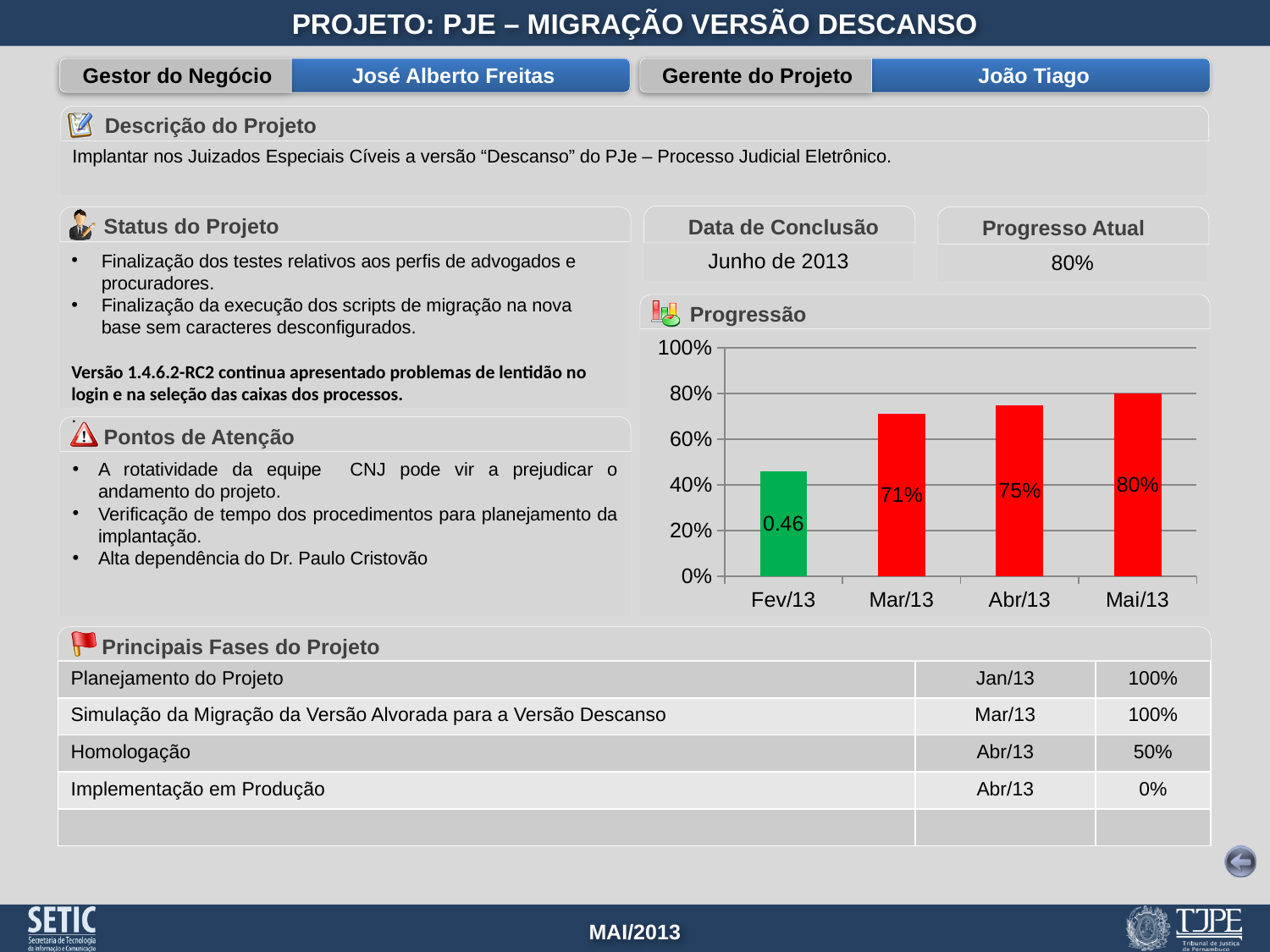
What is the value shown for Mai/13 in the Progressão chart? 80% What type of chart is shown under the "Progressão" heading? Bar chart Do the values in the Progressão chart rise or fall from Fev/13 to Mai/13? Rise Which month has the highest bar in the Progressão chart? Mai/13 What data label is printed on the Fev/13 bar in the Progressão chart? 0.46 What is the value shown for Abr/13 in the Progressão chart? 75% In the Progressão chart, which is larger: the value for Abr/13 or the value for Mar/13? Abr/13 Which month has the lowest bar in the Progressão chart? Fev/13 How many months are plotted in the Progressão chart? 4 In the Progressão chart, what is the difference between the Mai/13 and Mar/13 values? 9 percentage points What is the value shown for Mar/13 in the Progressão chart? 71% In the Progressão chart, which bar is coloured green rather than red? Fev/13